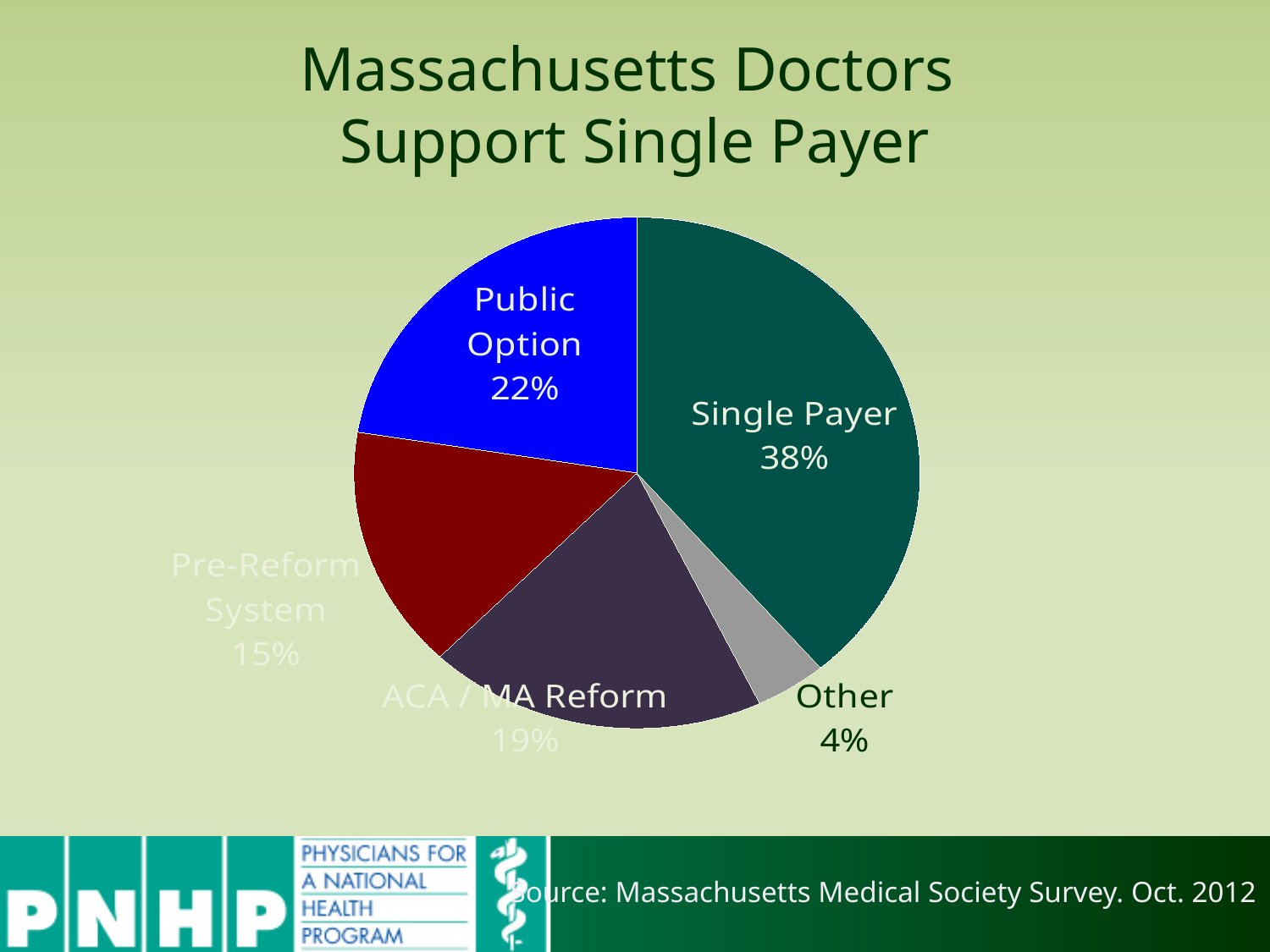
What percentage is shown for Pre-Reform System? 15% What percentage is shown for Other? 4% What is the title of the chart on the slide? Massachusetts Doctors Support Single Payer What percentage is shown for Public Option? 22% What percentage is shown for ACA / MA Reform? 19% How many slices does the pie chart have? 5 Which is larger, the share for Public Option or the share for ACA / MA Reform? Public Option Which option has the smallest share of the pie? Other Which option has the largest share of the pie? Single Payer What is the difference in percentage points between Single Payer and Public Option? 16 What percentage of Massachusetts doctors support Single Payer? 38% What kind of chart is shown on the slide? Pie chart